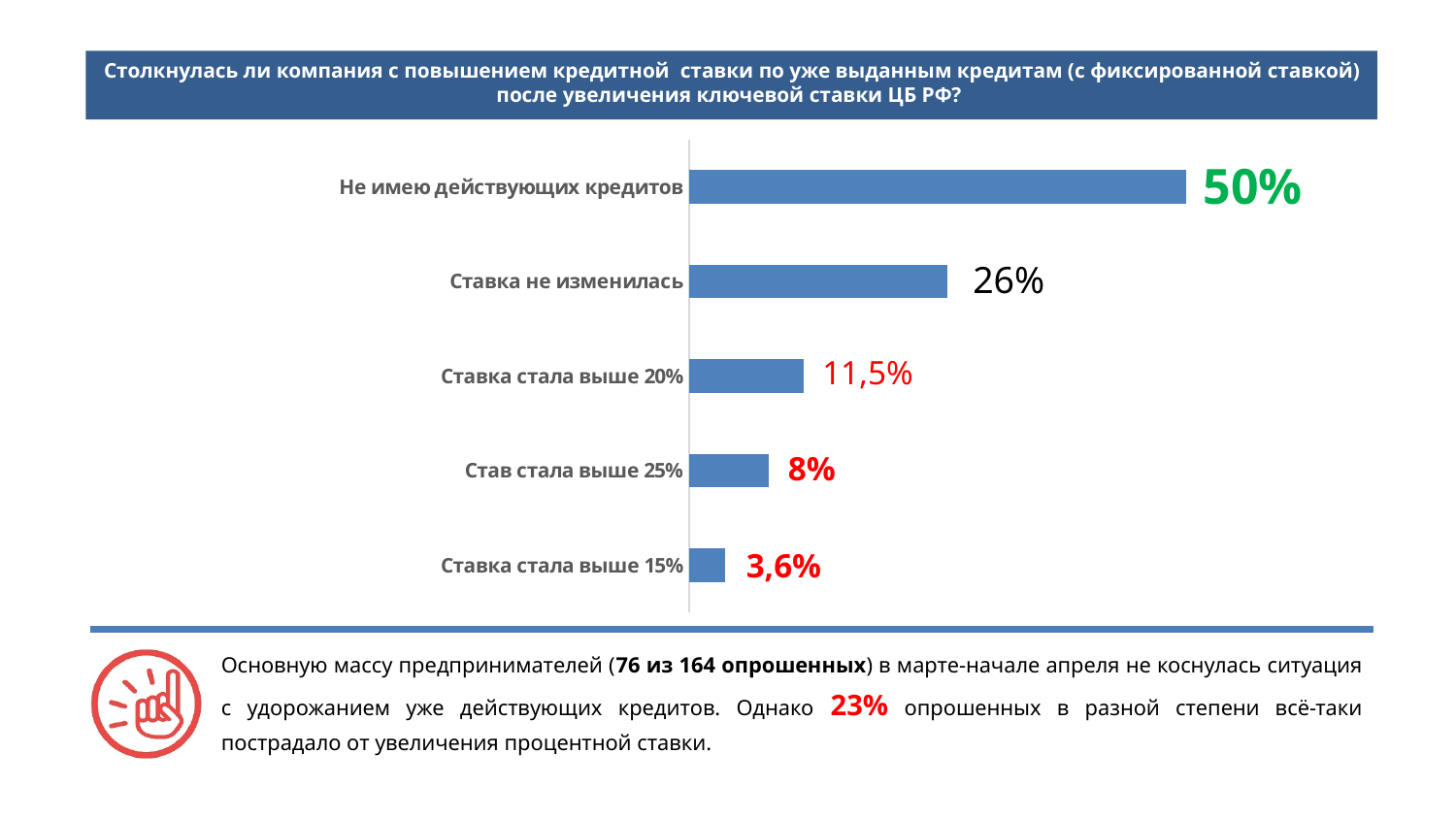
What is the value for «Ставка стала выше 20%»? 11,5% What is the difference between «Не имею действующих кредитов» and «Ставка не изменилась»? 24% What is the value for «Став стала выше 25%»? 8% What kind of chart is shown on the slide? Bar chart Which category has the highest value? Не имею действующих кредитов Which is larger: «Ставка стала выше 20%» or «Став стала выше 25%»? Ставка стала выше 20% How many categories are shown in the chart? 5 Which category has the lowest value? Ставка стала выше 15% What is the value for «Ставка стала выше 15%»? 3,6% What colour are the bars in the chart? Blue What is the value for «Ставка не изменилась»? 26% What is the value for «Не имею действующих кредитов»? 50%